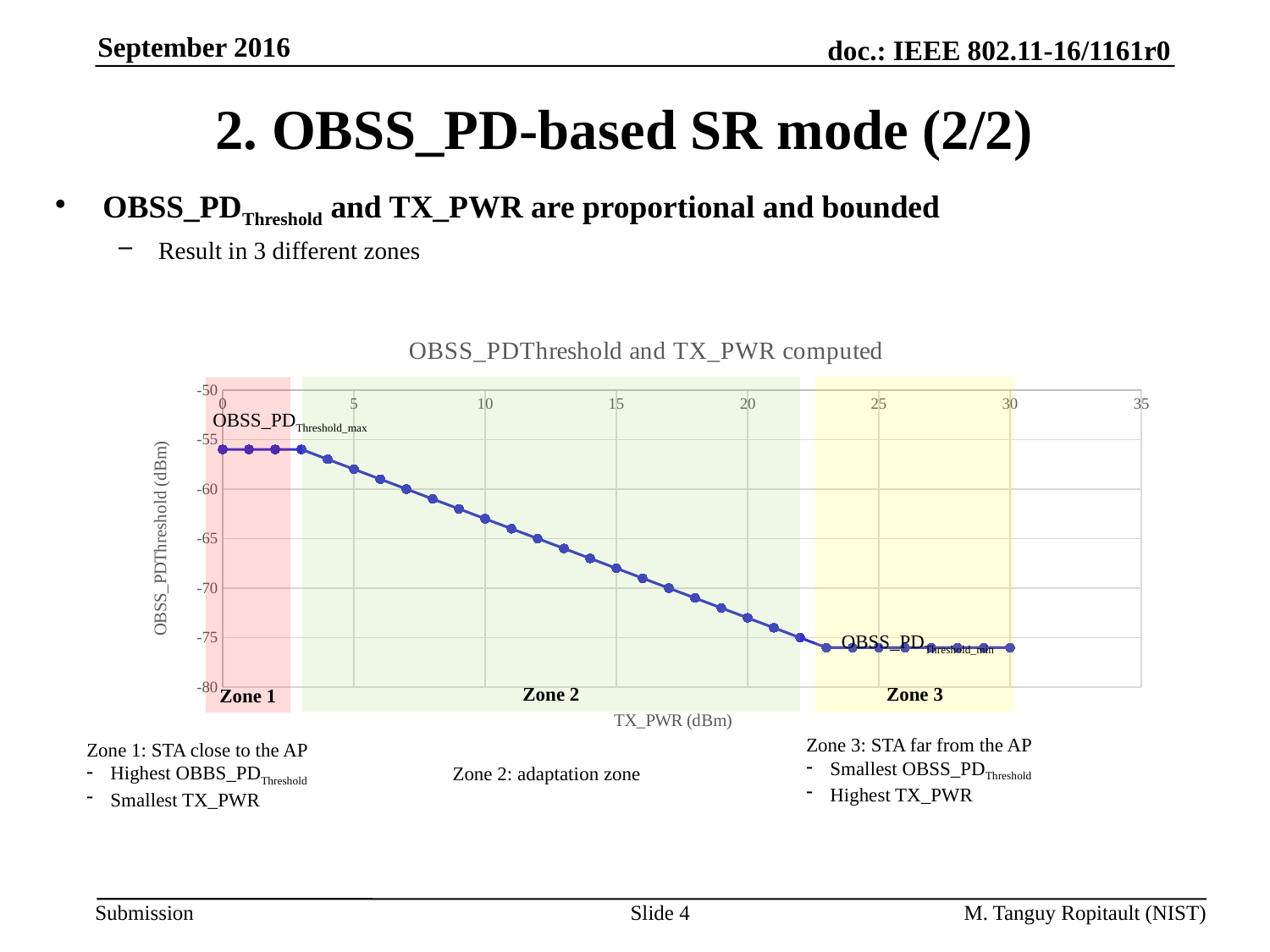
Is the OBSS_PDThreshold value at TX_PWR 20 dBm greater or less than -70? less Does the plotted OBSS_PDThreshold value rise or fall as TX_PWR increases from 5 to 20 dBm? fall How many plotted points are on the line in the chart? 31 Is the OBSS_PDThreshold value at TX_PWR 5 dBm greater or less than -60? greater Which has the larger OBSS_PDThreshold value: TX_PWR 0 dBm or TX_PWR 30 dBm? TX_PWR 0 dBm What is the label of the x axis of the chart? TX_PWR (dBm) Which has the larger OBSS_PDThreshold value: TX_PWR 10 dBm or TX_PWR 20 dBm? TX_PWR 10 dBm What is the title of the chart? OBSS_PDThreshold and TX_PWR computed What kind of chart is shown on the slide? line chart Is the OBSS_PDThreshold value at TX_PWR 10 dBm greater or less than -60? less